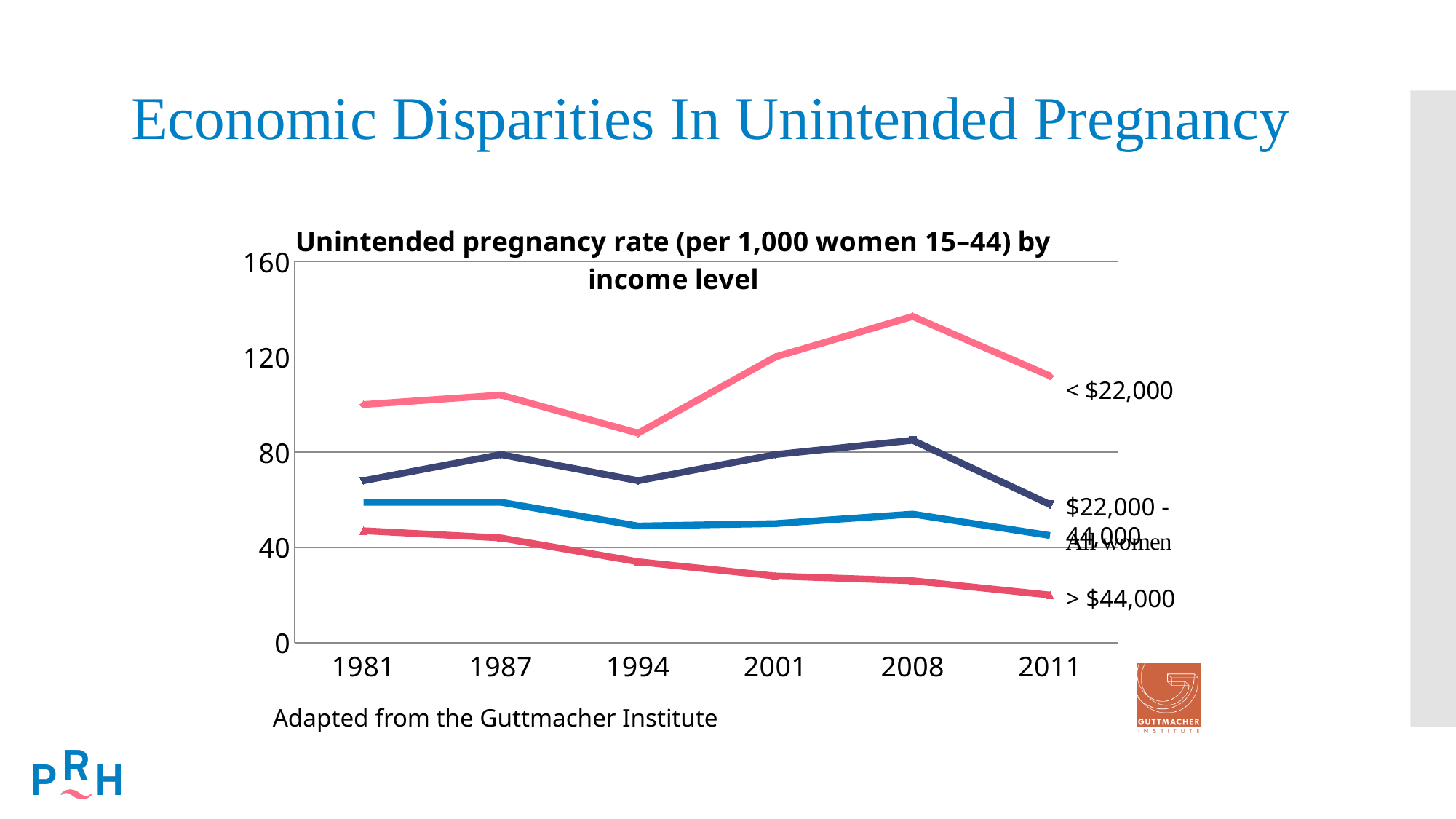
What kind of chart is shown on the slide? line chart Is the value for $22,000 - 44,000 in 1981 greater or less than 80? less Does the > $44,000 line rise or fall from 1981 to 2011? fall In which year does the < $22,000 line reach its highest point? 2008 Is the value for < $22,000 in 2008 greater or less than 120? greater How many lines (income groups) are plotted on the chart? 4 Is the value for > $44,000 in 2011 greater or less than 40? less How many years are shown along the x axis of the chart? 6 Which income group has the lowest unintended pregnancy rate in 2011? > $44,000 In 1994, which is larger: the rate for < $22,000 or the rate for All women? < $22,000 What is the title of the chart? Unintended pregnancy rate (per 1,000 women 15–44) by income level Which income group has the highest unintended pregnancy rate in 2008? < $22,000